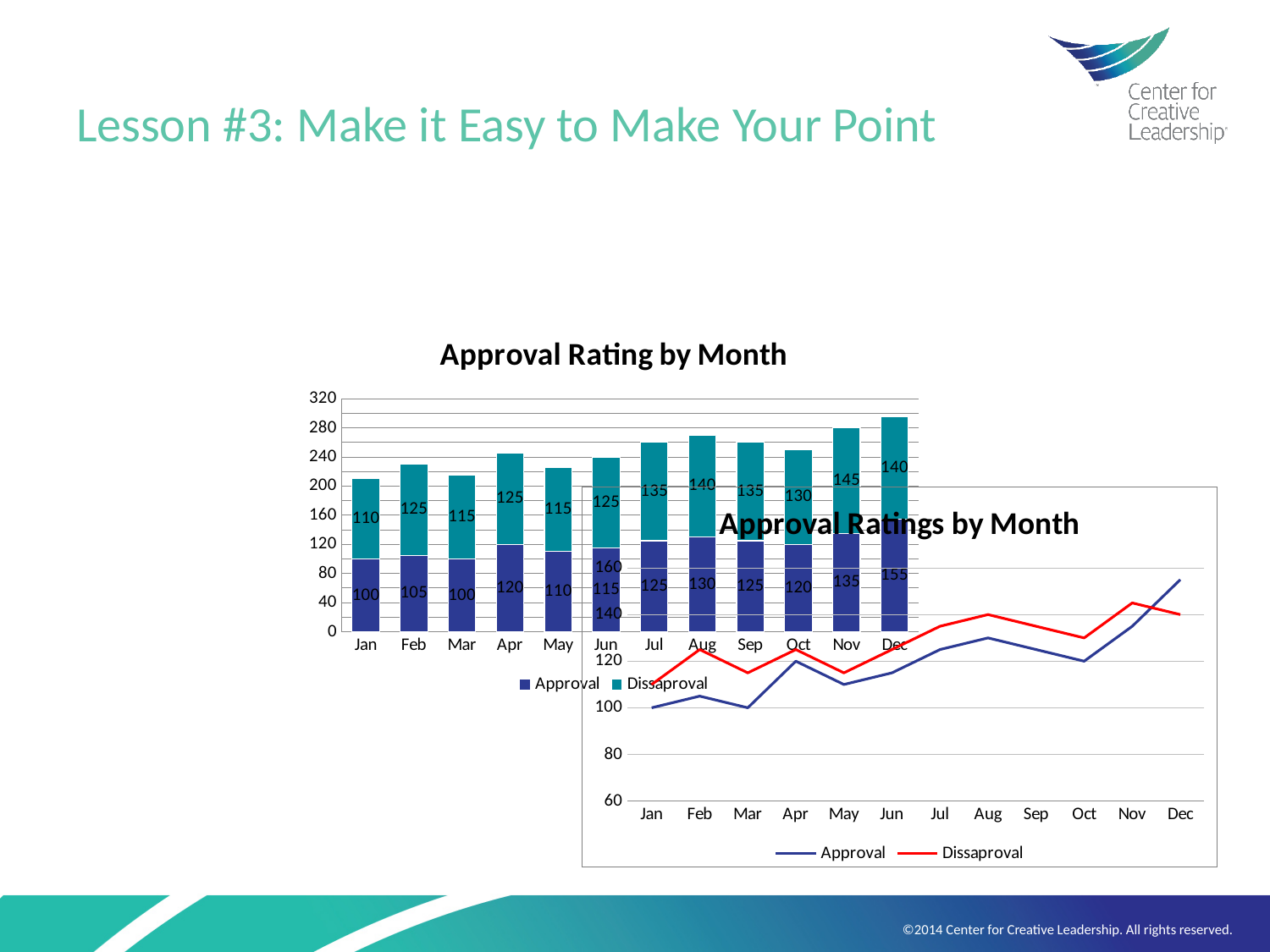
In the stacked bar chart titled "Approval Rating by Month", which is larger: the Approval value for Apr or the Approval value for May? Apr In the stacked bar chart titled "Approval Rating by Month", what is the Dissaproval value for Aug? 140 What kind of chart is the chart titled "Approval Ratings by Month" on the right? line chart In the stacked bar chart titled "Approval Rating by Month", what is the total of the stacked bar for Nov? 280 In the stacked bar chart titled "Approval Rating by Month", what is the Approval value for Dec? 155 In the stacked bar chart titled "Approval Rating by Month", how many series does the legend list? 2 In the line chart titled "Approval Ratings by Month", what colour is the Dissaproval line? red In the stacked bar chart titled "Approval Rating by Month", what is the difference between the Dissaproval values for Feb and Jan? 15 In the line chart titled "Approval Ratings by Month", is the Approval value for Mar greater or less than 120? less How many months are shown on the x axis of the line chart titled "Approval Ratings by Month"? 12 In the stacked bar chart titled "Approval Rating by Month", which month has the highest Approval value? Dec In the stacked bar chart titled "Approval Rating by Month", what is the Approval value for Jan? 100